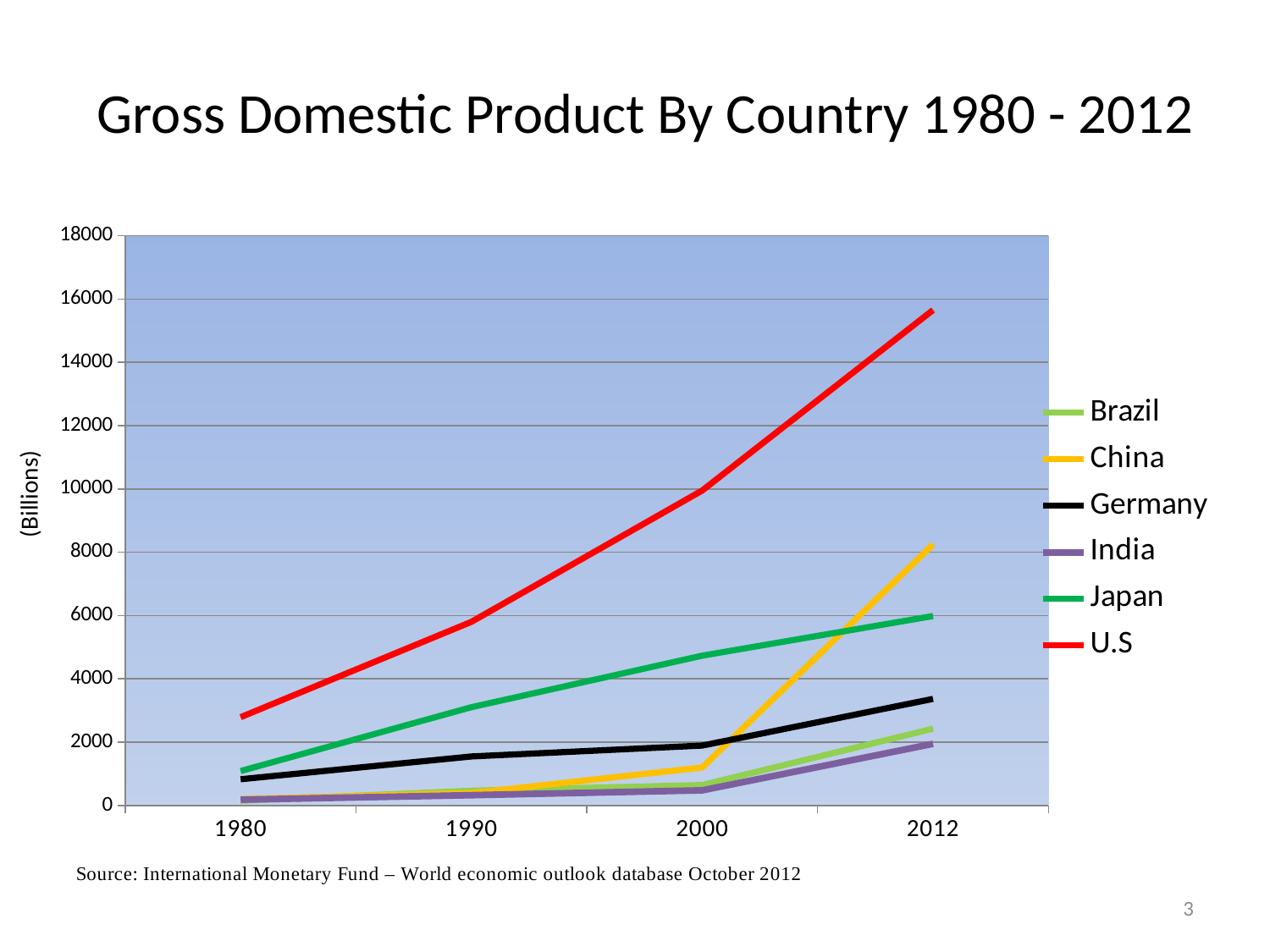
What is the label on the y axis? (Billions) Is the value for Germany in 2012 greater or less than 4000? less Does the U.S line rise or fall from 1980 to 2012? rise What kind of chart is shown on the slide? line chart Which country has the lowest GDP in 2012? India Is the value for the U.S in 2012 greater or less than 14000? greater Which country has the highest GDP in 2012? U.S How many years are marked along the x axis? 4 In 2012, which is larger, the GDP of China or of Japan? China How many countries does the legend list? 6 Is the value for Japan in 2012 greater or less than 8000? less In 2000, which is larger, the GDP of China or of Japan? Japan